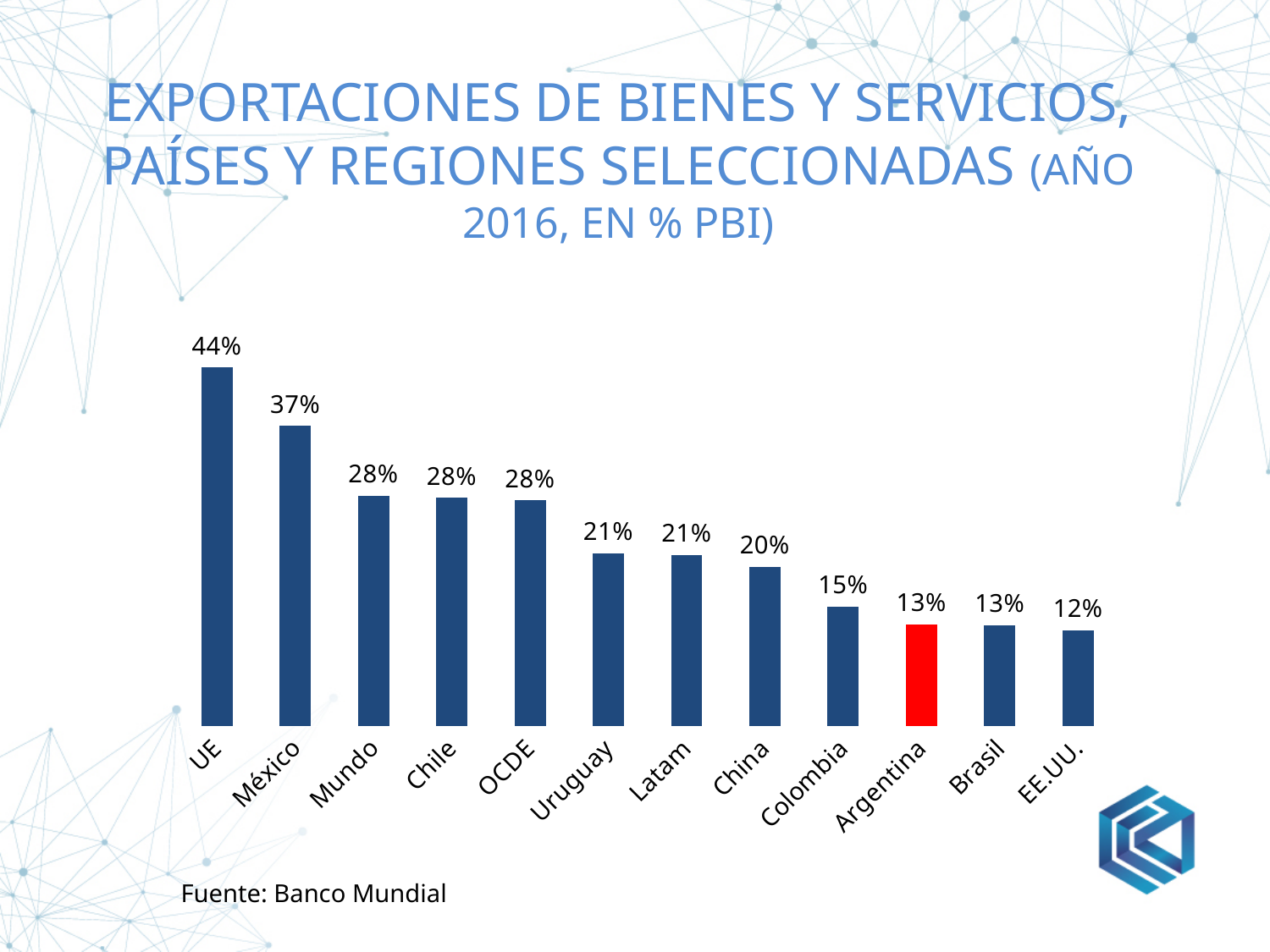
Which is larger, the value for Colombia or the value for Brasil? Colombia Which category's bar is coloured red? Argentina What is the value for Uruguay? 21% How many categories are shown in the chart? 12 What kind of chart is shown on the slide? Bar chart What is the value for Argentina? 13% What is the difference between the values for Mundo and China? 8% Do the values generally rise or fall from left to right along the x axis? Fall Which category has the lowest value? EE.UU. What is the value for México? 37% Which category has the highest value? UE What is the difference between the values for UE and Argentina? 31%